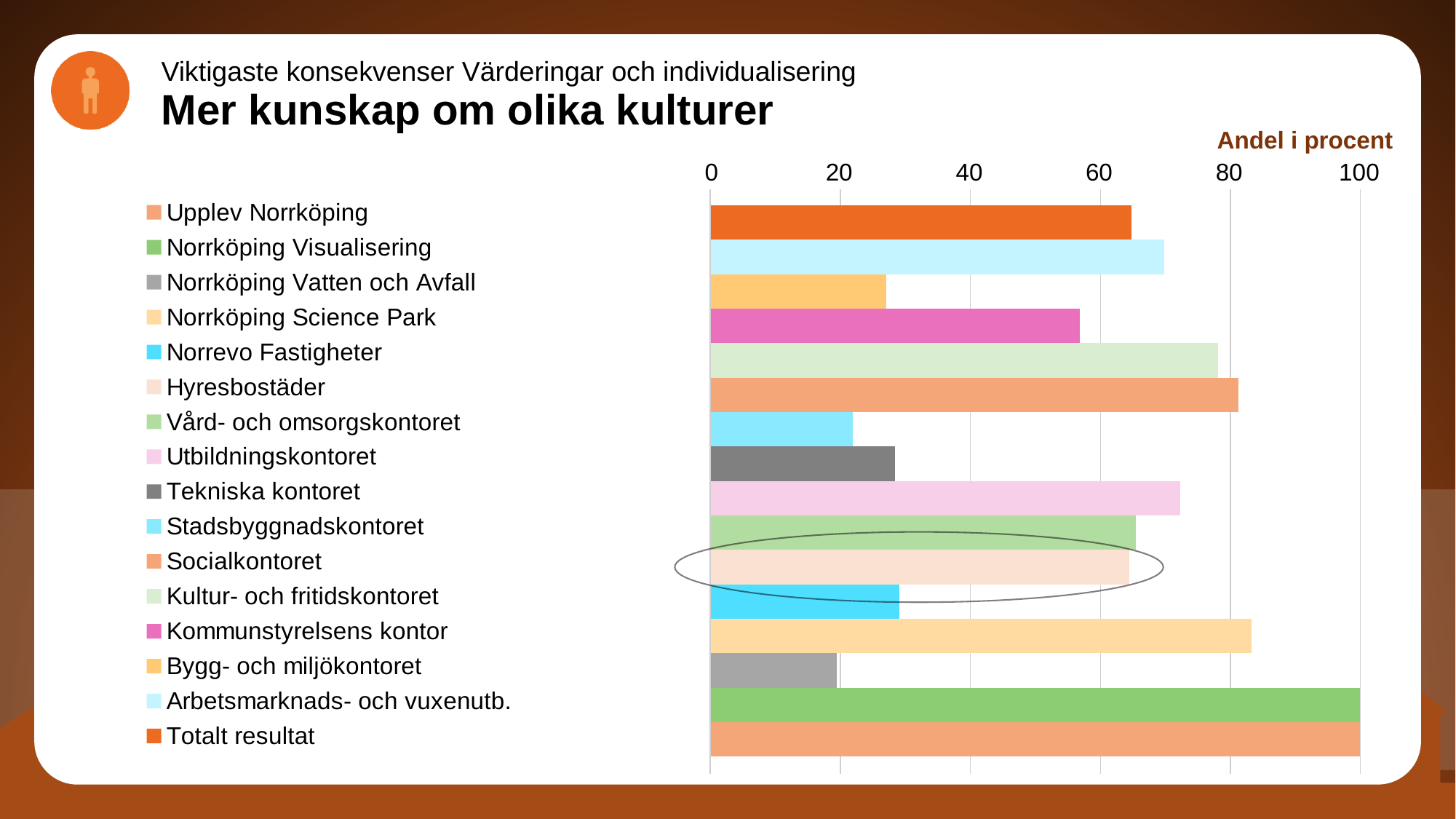
Which is larger, the value for Socialkontoret or the value for Stadsbyggnadskontoret? Socialkontoret How many series does the legend list? 16 What is the value for Upplev Norrköping? 100 Is the value for Bygg- och miljökontoret greater or less than 40? less Which is larger, the value for Kultur- och fritidskontoret or the value for Bygg- och miljökontoret? Kultur- och fritidskontoret Is the value for Stadsbyggnadskontoret greater or less than 40? less What kind of chart is shown on the slide? bar chart Is the value for Kommunstyrelsens kontor greater or less than 40? greater What label is shown above the horizontal axis of the chart? Andel i procent What is the value for Norrköping Visualisering? 100